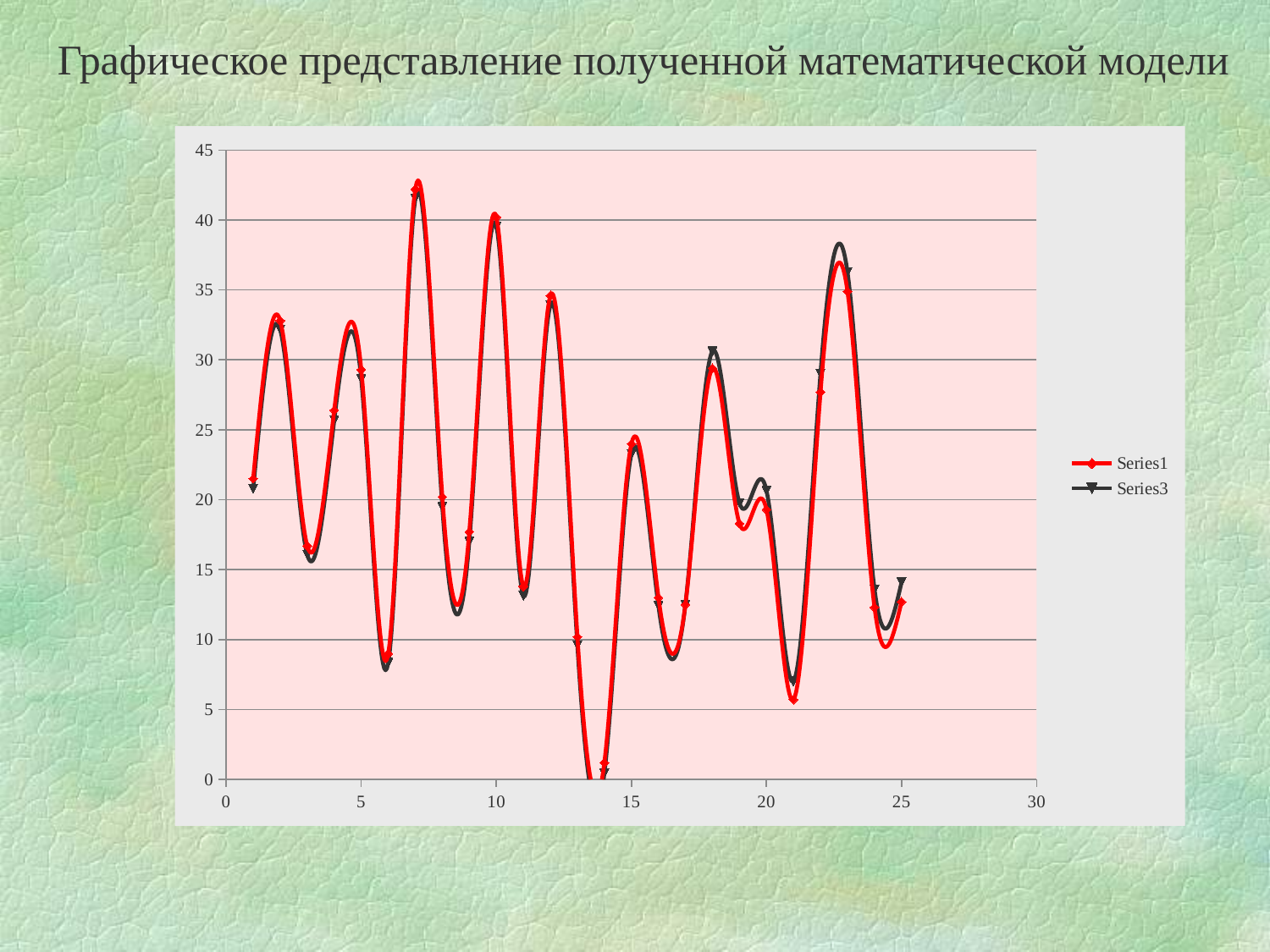
Is the value of Series1 at x = 2 greater or less than 30? greater How many series does the legend list? 2 At which x value does Series1 reach its lowest point? 14 What kind of chart is shown on the slide? Line chart Is the value of Series1 at x = 21 greater or less than 10? less What is the maximum value shown on the vertical axis? 45 What colour is the line for Series1? Red At which x value does Series1 reach its highest point? 7 Is the value of Series1 at x = 14 greater or less than 5? less What are the names of the series listed in the legend? Series1 and Series3